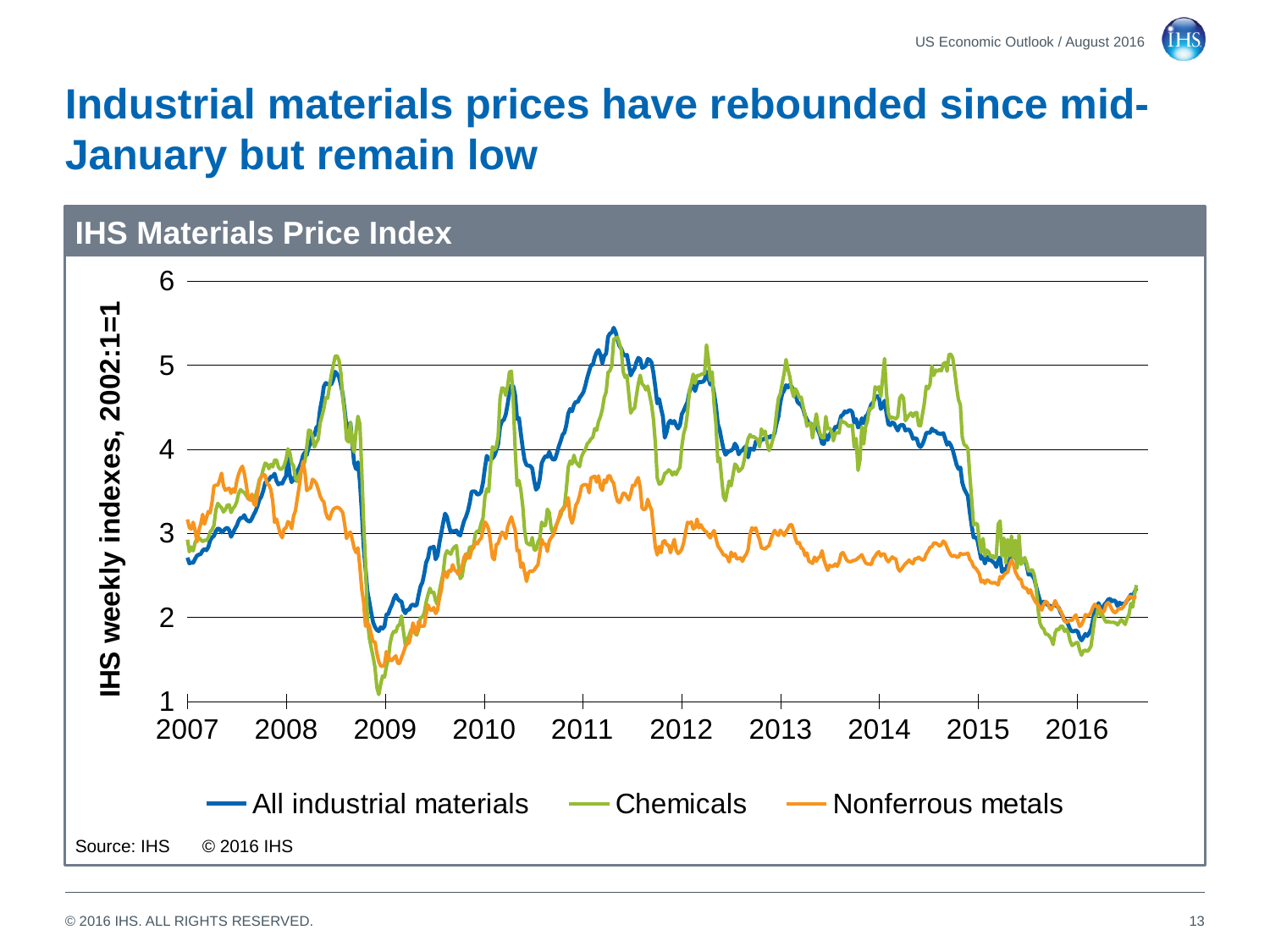
During 2014, which series is higher: All industrial materials or Nonferrous metals? All industrial materials Is the value for All industrial materials in 2016 greater or less than 3? less What is the label on the vertical axis? IHS weekly indexes, 2002:1=1 Is the value for Nonferrous metals during 2014 greater or less than 3? less How many series does the legend list? 3 Is the peak value for All industrial materials in 2011 greater or less than 5? greater What kind of chart is shown on the slide? line chart What is the title of the chart? IHS Materials Price Index Does the All industrial materials line rise or fall from 2014 to early 2016? fall Which series has the lowest values during 2013 and 2014? Nonferrous metals